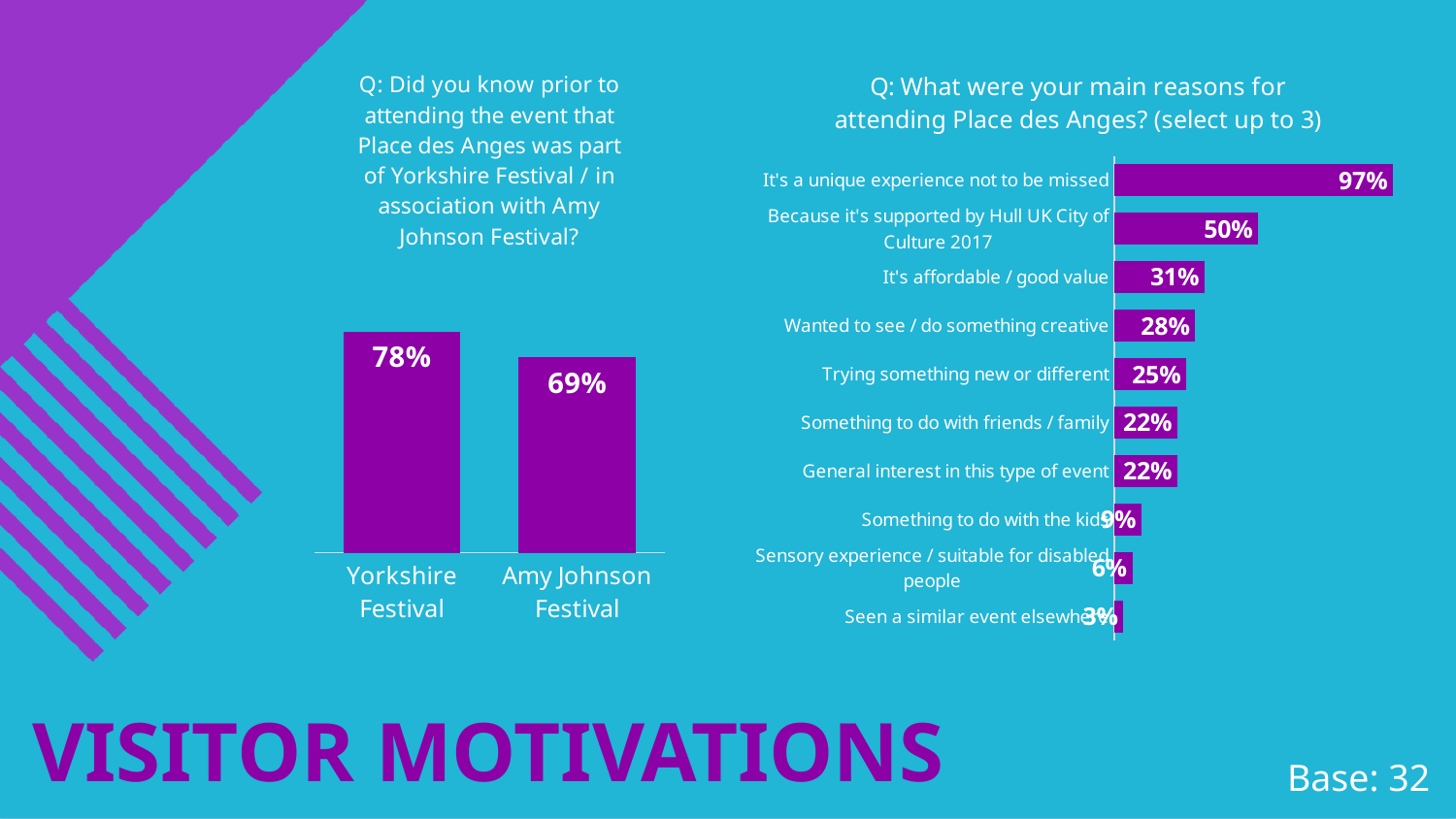
What is the base (number of respondents) shown on the slide? 32 What kind of chart is the left chart about prior awareness? Bar chart In the left chart about prior awareness, which festival has the higher value? Yorkshire Festival In the right chart about main reasons for attending, what is the difference between 'It's affordable / good value' and 'Wanted to see / do something creative'? 3% In the right chart about main reasons for attending, which reason has the lowest value? Seen a similar event elsewhere In the right chart about main reasons for attending, what percentage selected 'It's a unique experience not to be missed'? 97% In the right chart about main reasons for attending, what percentage selected 'Because it's supported by Hull UK City of Culture 2017'? 50% In the right chart about main reasons for attending, which reason has the highest value? It's a unique experience not to be missed In the right chart about main reasons for attending, how many reasons are listed? 10 In the left chart about prior awareness, what percentage of visitors knew the event was in association with Amy Johnson Festival? 69% In the left chart about prior awareness, what percentage of visitors knew Place des Anges was part of Yorkshire Festival? 78% In the left chart about prior awareness, what is the difference between the Yorkshire Festival and Amy Johnson Festival values? 9%